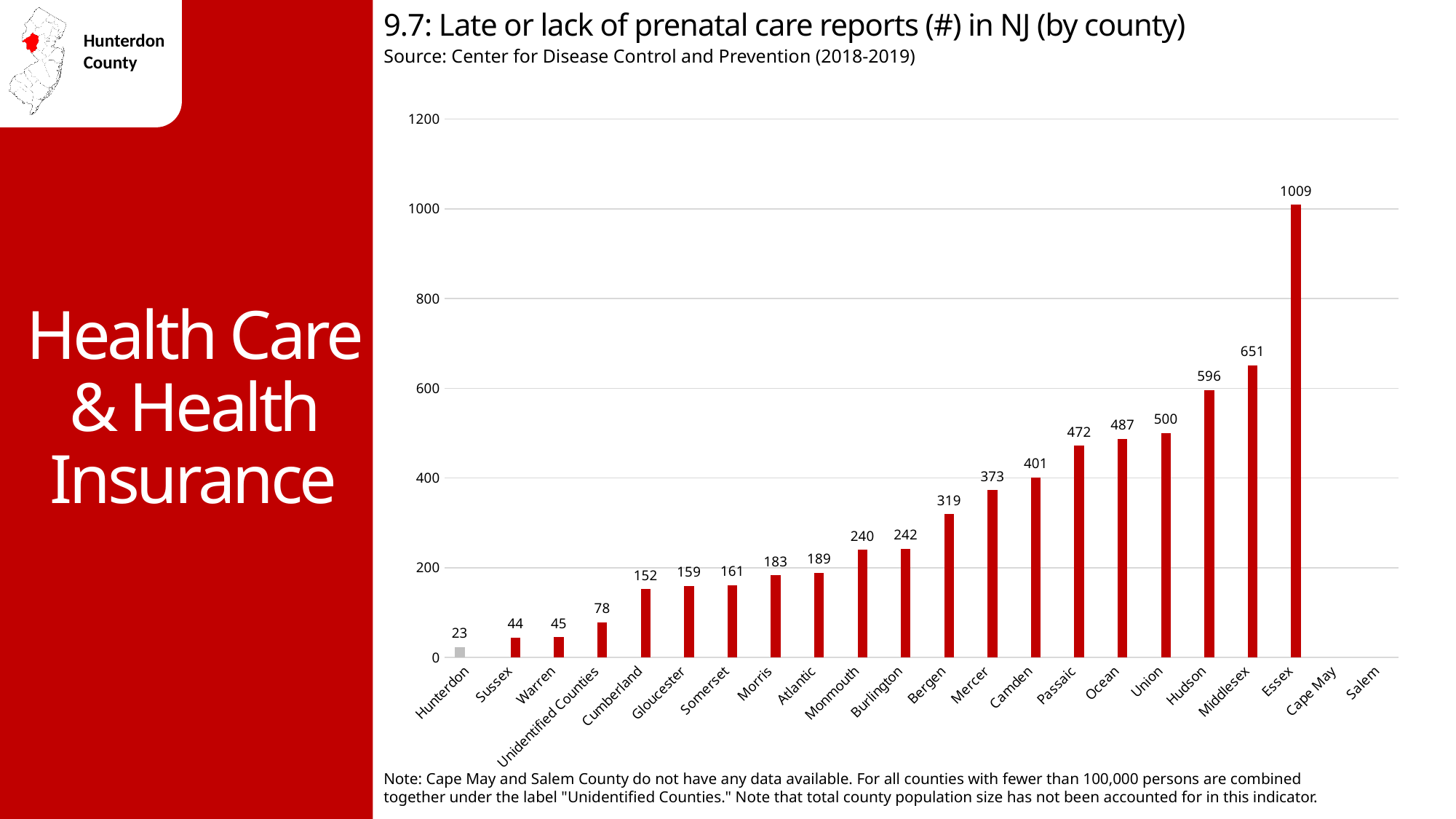
How many categories are labelled on the x axis? 22 What is the value shown for Essex? 1009 Which two counties on the x axis have no data shown? Cape May and Salem Is the value for Passaic greater or less than 400? greater What is the difference between the values for Middlesex and Hudson? 55 What is the value shown for Monmouth? 240 Which county has the highest number of late or lack of prenatal care reports? Essex What is the number of late or lack of prenatal care reports for Hunterdon? 23 Which county with data shown has the lowest number of reports? Hunterdon Which has a larger value, Bergen or Mercer? Mercer What kind of chart is shown on the slide? Bar chart Do the values generally rise or fall from left to right across the counties with data? Rise